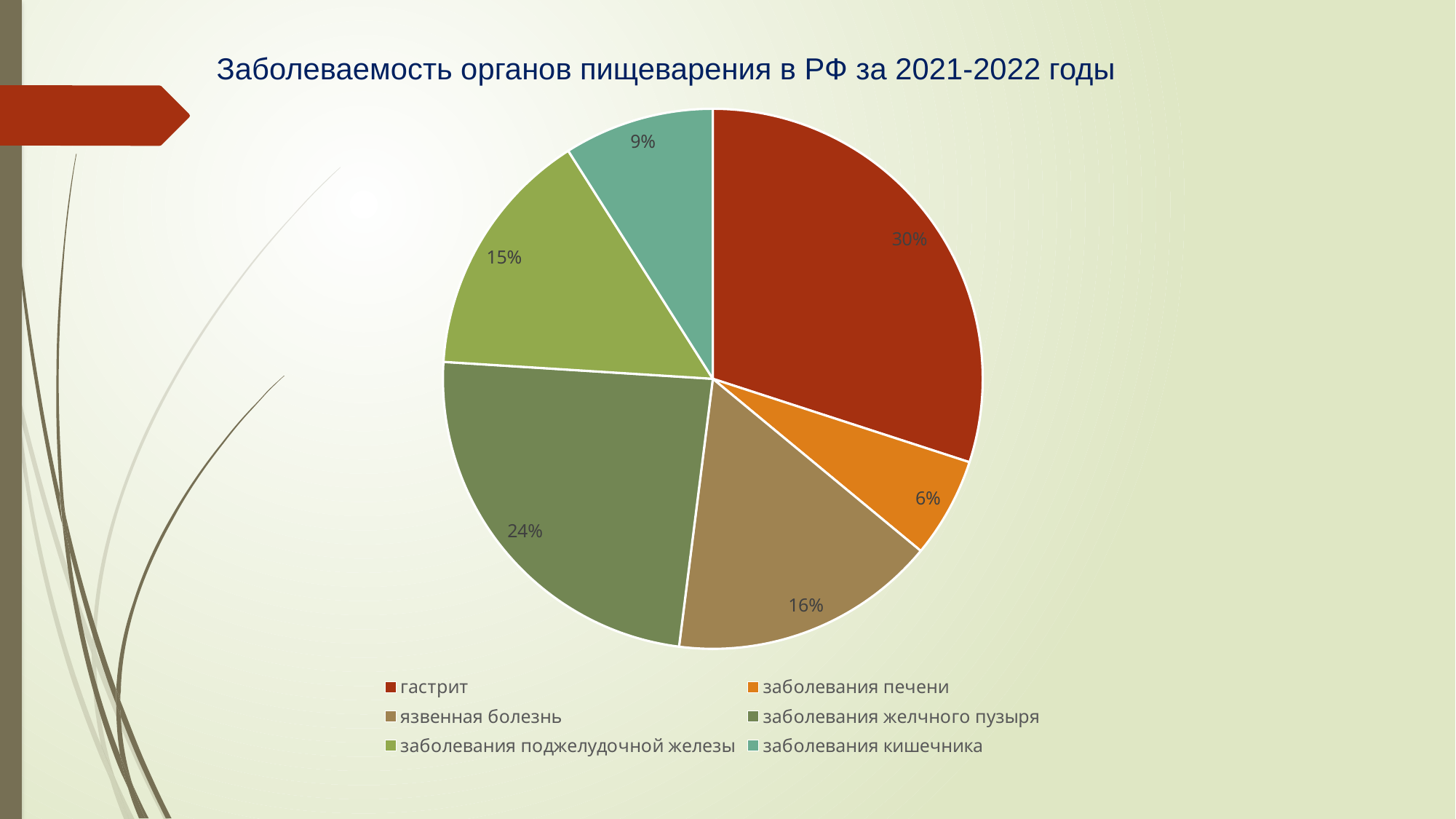
Which is larger, the share of язвенная болезнь or the share of заболевания поджелудочной железы? язвенная болезнь How many categories does the legend list? 6 What share of the pie does язвенная болезнь have? 16% What share of the pie does заболевания поджелудочной железы have? 15% What is the difference between the shares of гастрит and заболевания желчного пузыря? 6% Which category has the largest slice of the pie? гастрит What kind of chart is shown on the slide? pie chart What share of the pie does гастрит have? 30% Which category has the smallest slice of the pie? заболевания печени